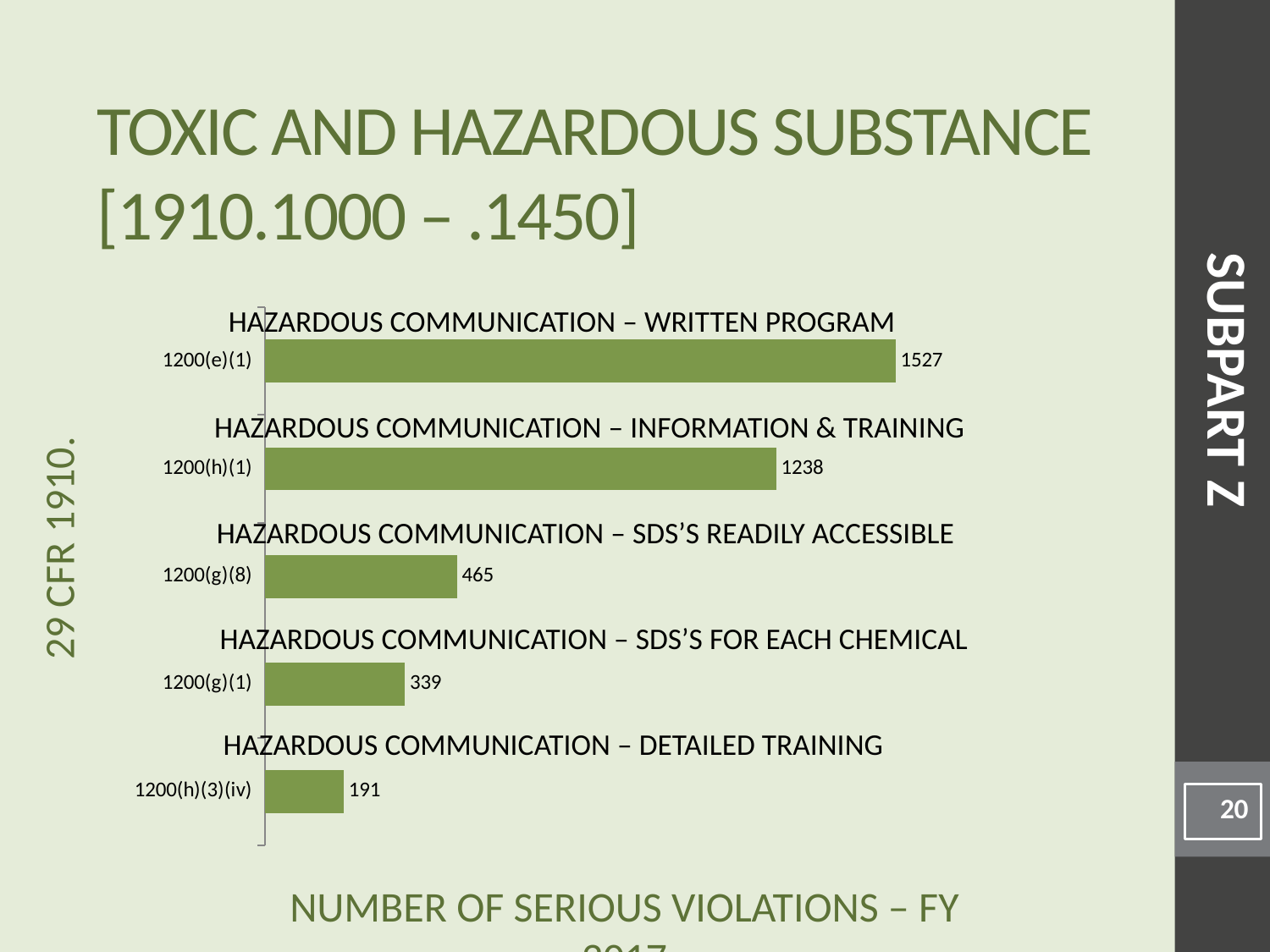
What is the number of serious violations for 1200(g)(8)? 465 What is the difference between the values for 1200(e)(1) and 1200(h)(1)? 289 What kind of chart is shown on the slide? Bar chart What is the difference between the values for 1200(g)(8) and 1200(g)(1)? 126 What is the number of serious violations for 1200(e)(1)? 1527 How many categories are shown in the chart? 5 What is the number of serious violations for 1200(h)(3)(iv)? 191 Which has a larger value, 1200(g)(1) or 1200(h)(3)(iv)? 1200(g)(1) What is the number of serious violations for 1200(h)(1)? 1238 Which category has the lowest number of serious violations? 1200(h)(3)(iv) Which category has the highest number of serious violations? 1200(e)(1) What is the label shown for the bar with value 339? 1200(g)(1)